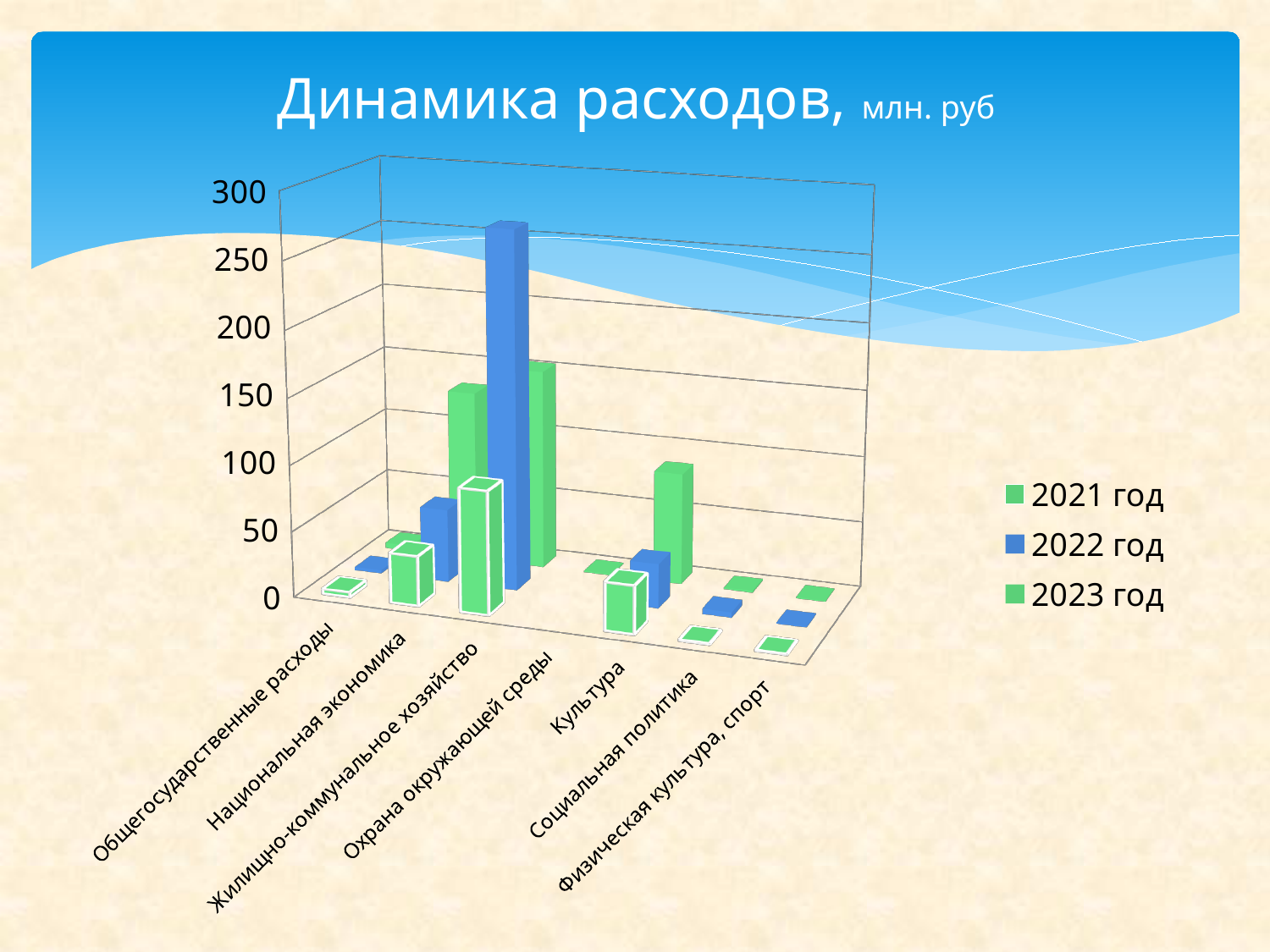
In the 2022 год series, which is larger: Национальная экономика or Социальная политика? Национальная экономика What is the title of the chart? Динамика расходов, млн. руб For the 2022 год series, which category has the highest value? Жилищно-коммунальное хозяйство Which years are listed in the legend? 2021 год, 2022 год, 2023 год What kind of chart is shown on the slide? Bar chart Is the 2022 год value for Общегосударственные расходы greater or less than 50? less How many series does the legend list? 3 Which category has the tallest bar in the whole chart? Жилищно-коммунальное хозяйство Is the 2022 год value for Культура greater or less than 100? less How many expenditure categories are shown on the x axis? 7 In the 2022 год series, which is larger: Жилищно-коммунальное хозяйство or Национальная экономика? Жилищно-коммунальное хозяйство Is the 2022 год value for Жилищно-коммунальное хозяйство greater or less than 200? greater